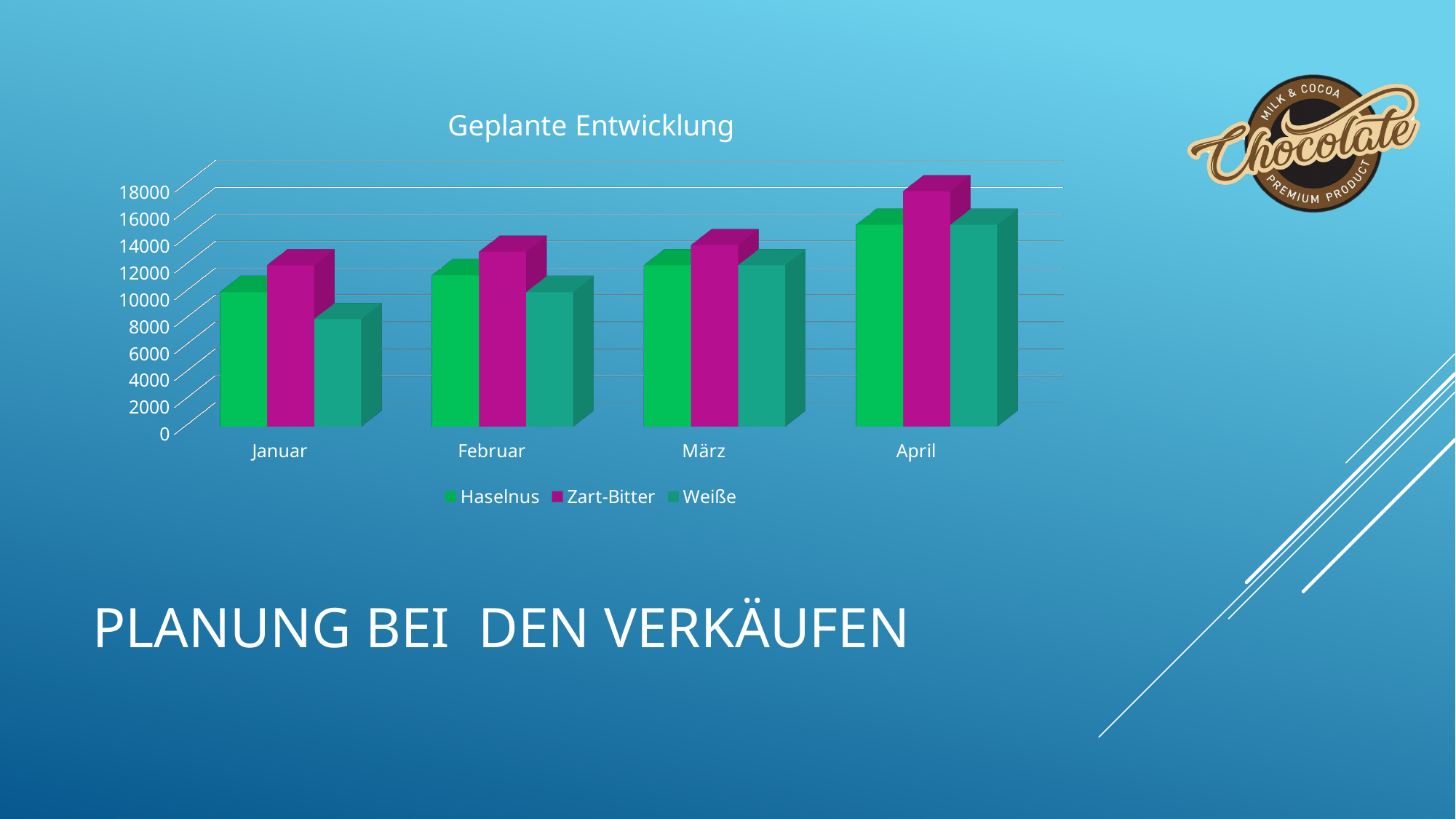
What type of chart is shown on the slide? Bar chart What is the title of the chart? Geplante Entwicklung Do the Zart-Bitter values rise or fall from Januar to April? rise Is the value for Haselnus in Januar greater or less than 14000? less Is the value for Weiße in Januar greater or less than 10000? less Is the value for Zart-Bitter in April greater or less than 14000? greater Which series is shown in magenta in the legend? Zart-Bitter How many series does the legend list? 3 In which month is the Zart-Bitter value highest? April In Januar, which is larger: Zart-Bitter or Weiße? Zart-Bitter How many months are shown on the x axis? 4 In which month is the Weiße value lowest? Januar